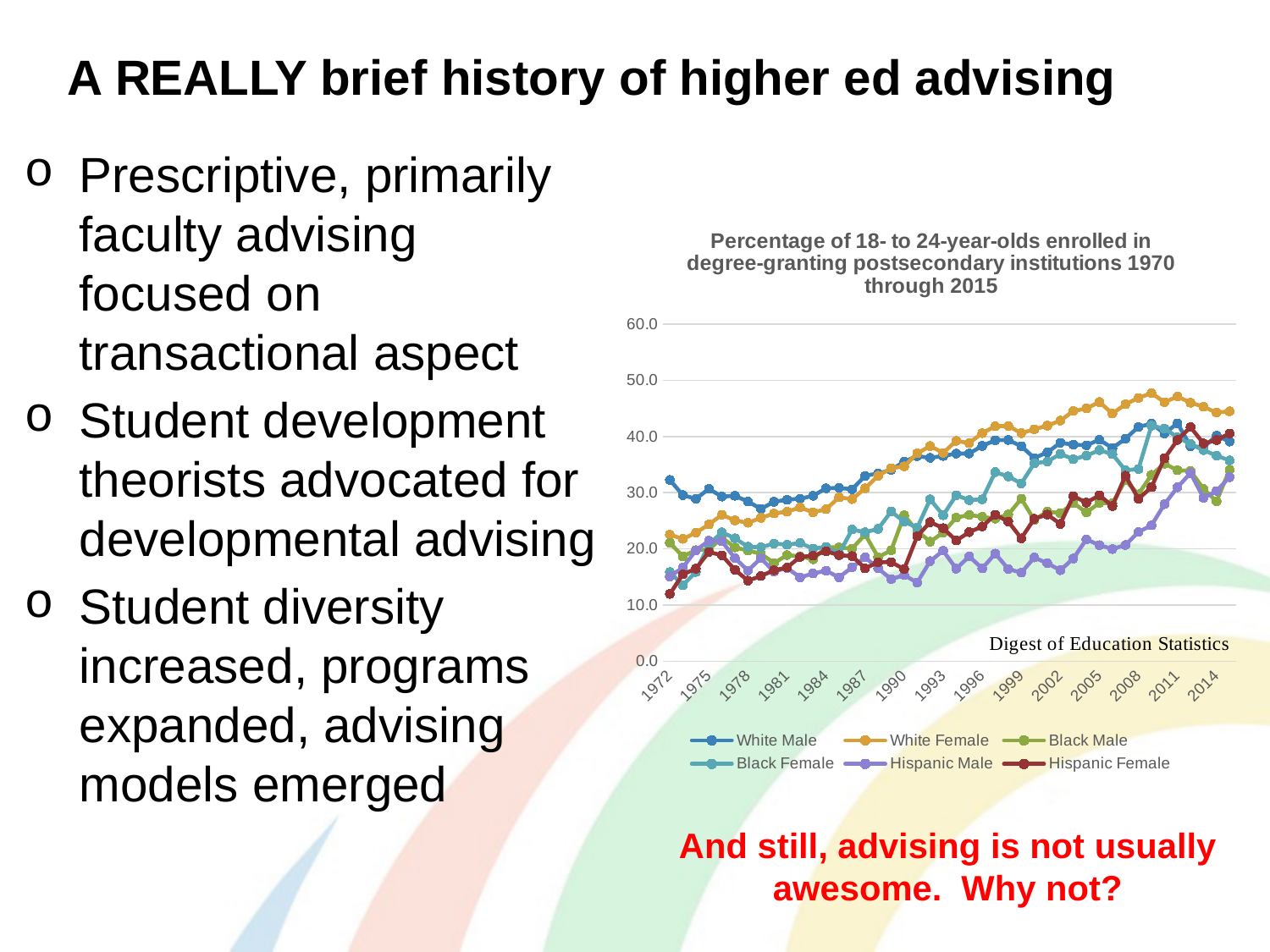
What kind of chart is shown on the slide? line chart How many year labels are shown on the x axis? 15 In 2014, which is larger: the value for White Female or the value for Hispanic Male? White Female Is the value for Black Male in 1978 greater or less than 30.0? less Is the value for White Female in 2011 greater or less than 40.0? greater Is the value for Hispanic Female in 1972 greater or less than 20.0? less Which series has the highest value at the right end of the chart (2014)? White Female Does the White Female series generally rise or fall from 1972 to 2014? rise How many series does the chart's legend list? 6 What is the title of the chart? Percentage of 18- to 24-year-olds enrolled in degree-granting postsecondary institutions 1970 through 2015 What source is cited on the chart? Digest of Education Statistics In 2011, which is larger: the value for White Female or the value for White Male? White Female